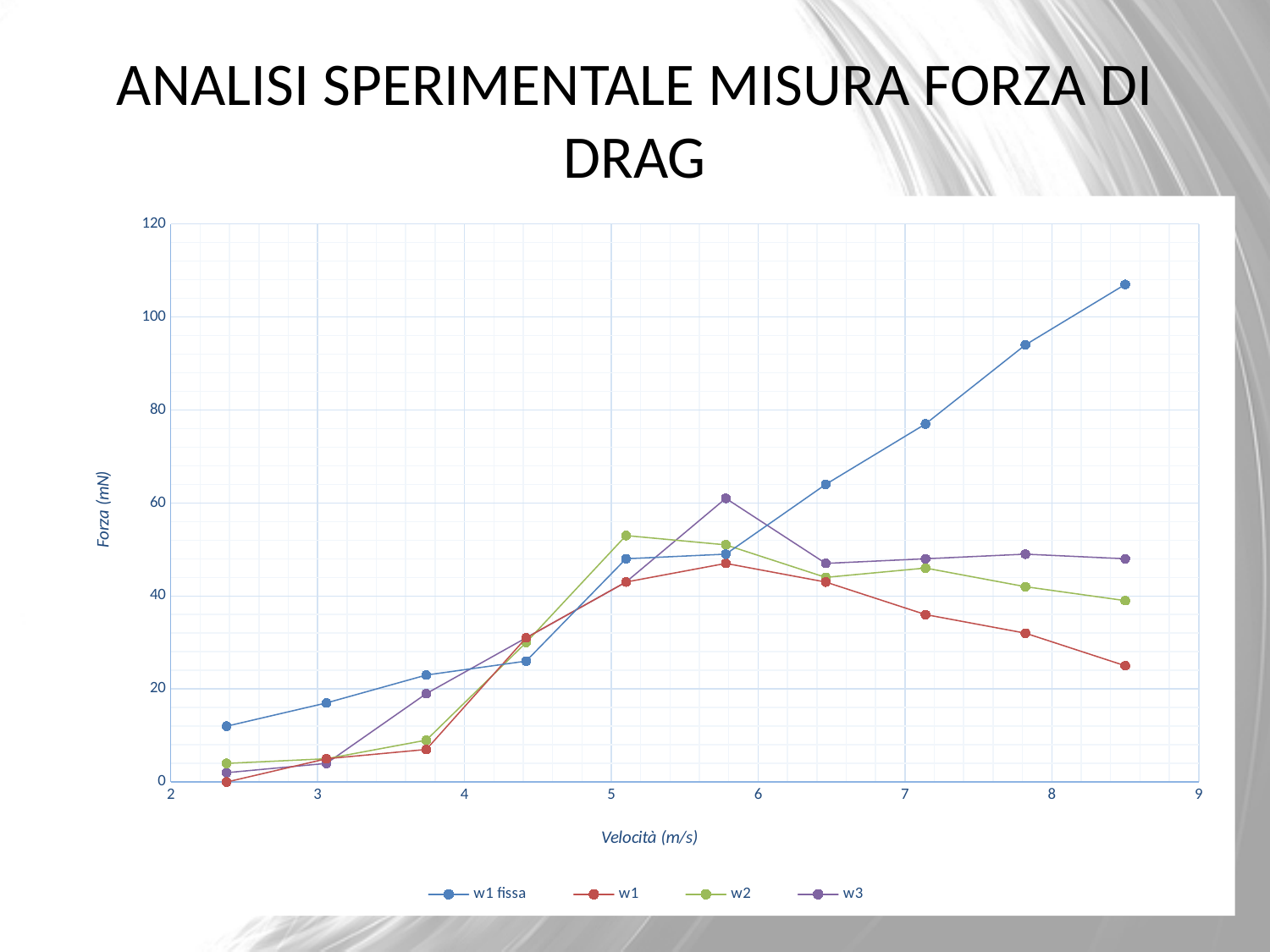
At the highest velocity plotted, which is larger: the force for w1 fissa or the force for w1? w1 fissa What kind of chart is shown on the slide? line chart Which series reaches the highest force value on the chart? w1 fissa At the highest velocity plotted, which is larger: the force for w3 or the force for w2? w3 What is the label of the vertical axis? Forza (mN) Is the force for w1 fissa at the highest velocity plotted greater or less than 100? greater How many data points does the w1 fissa series have? 10 Is the force for w1 at the highest velocity plotted greater or less than 20? greater At the highest velocity plotted, which series has the lowest force? w1 What is the label of the horizontal axis? Velocità (m/s) How many series does the legend list? 4 Does the force for w1 fissa rise or fall as velocity increases? rise